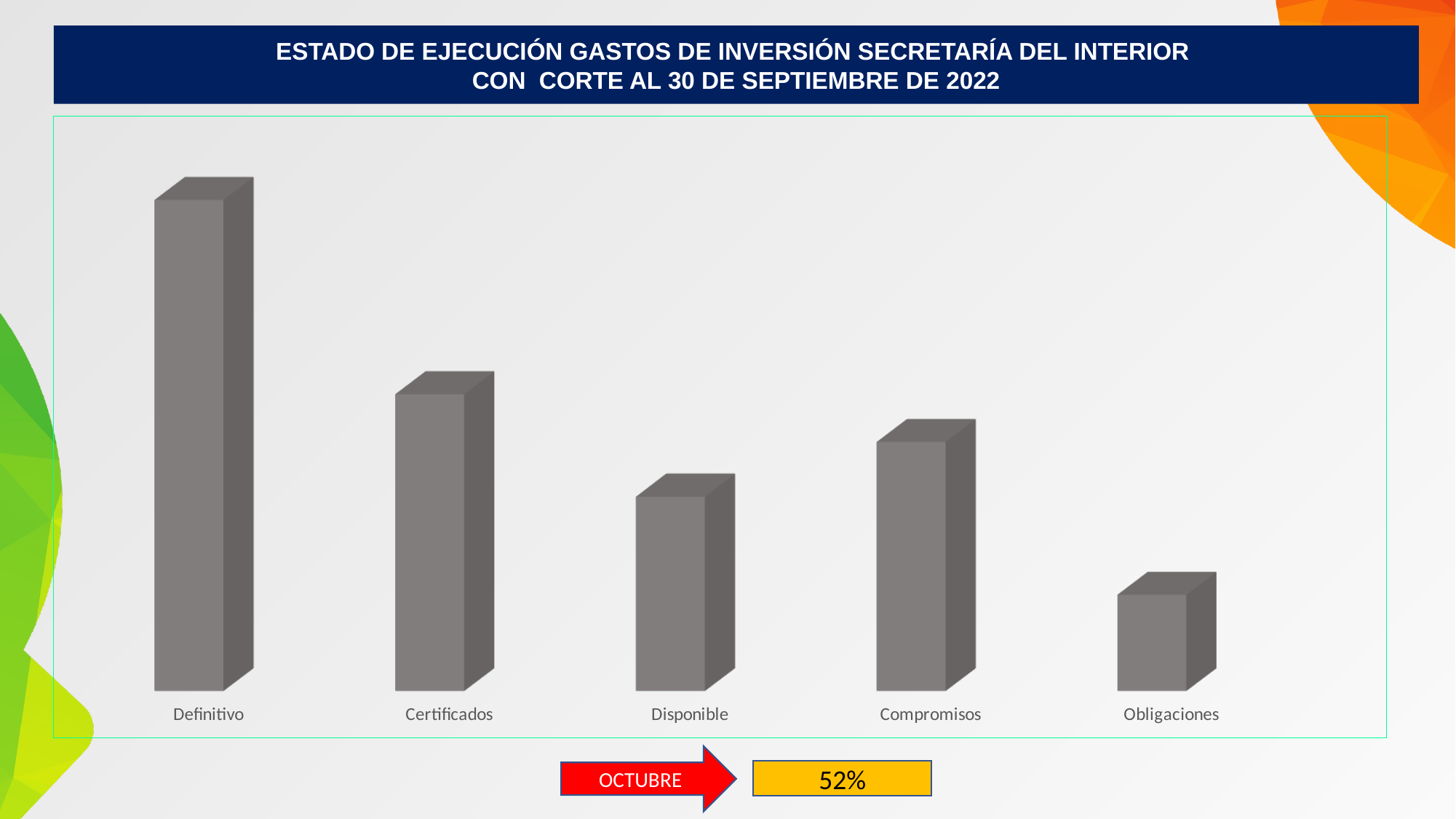
What is the title shown above the chart? ESTADO DE EJECUCIÓN GASTOS DE INVERSIÓN SECRETARÍA DEL INTERIOR CON CORTE AL 30 DE SEPTIEMBRE DE 2022 What kind of chart is shown on the slide? Bar chart Which is larger, the value for Certificados or the value for Compromisos? Certificados How many categories are plotted in the chart? 5 Which category has the highest bar? Definitivo Which is larger, the value for Disponible or the value for Compromisos? Compromisos What percentage is shown in the yellow box below the chart next to the OCTUBRE arrow? 52% Which category has the lowest bar? Obligaciones What is the second-highest category in the chart? Certificados Which is larger, the value for Definitivo or the value for Certificados? Definitivo